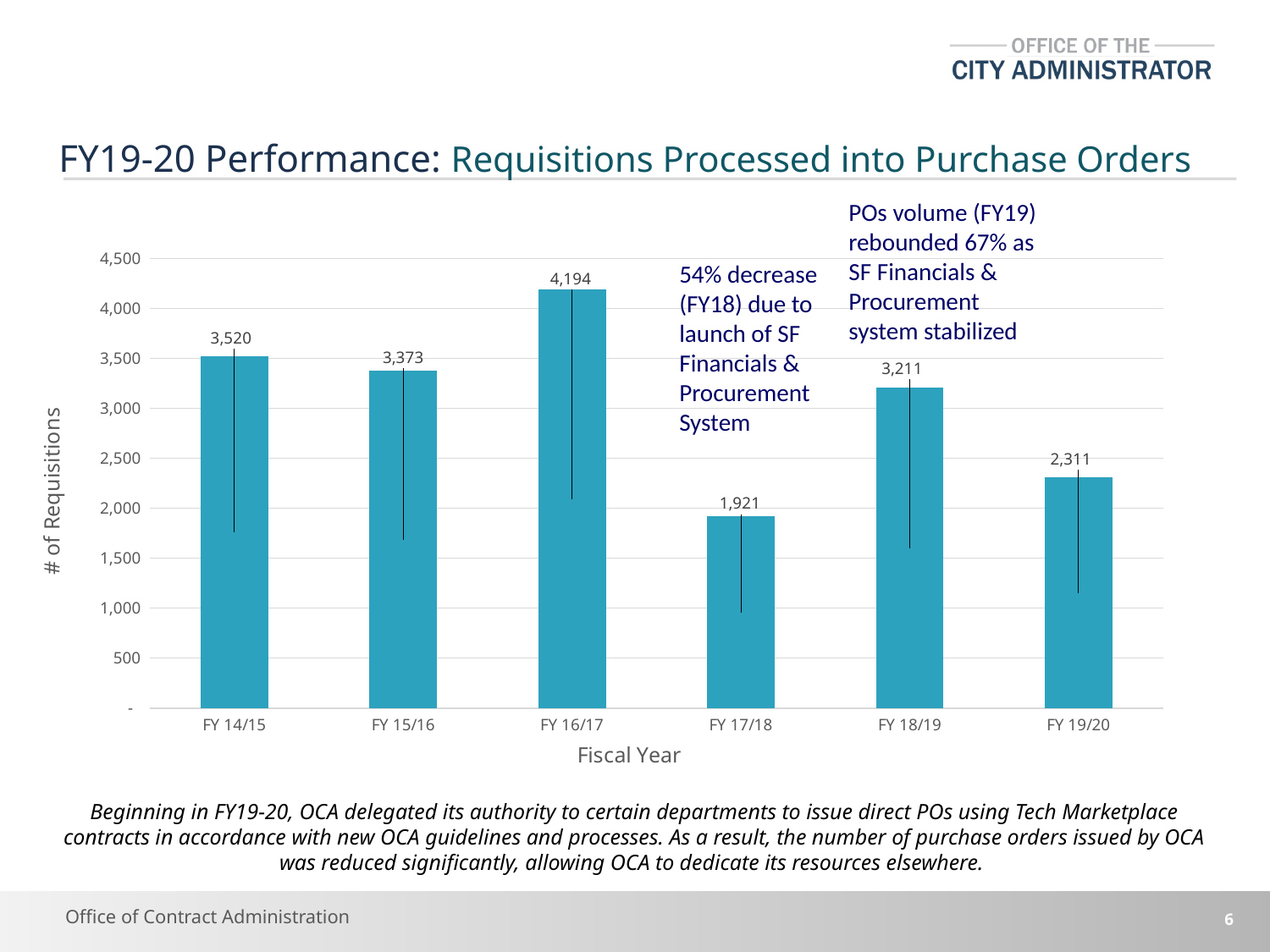
What kind of chart is shown on the slide? Bar chart Which fiscal year has the highest number of requisitions? FY 16/17 What is the number of requisitions for FY 16/17? 4,194 Which has more requisitions, FY 14/15 or FY 15/16? FY 14/15 What is the difference in requisitions between FY 18/19 and FY 19/20? 900 What is the number of requisitions for FY 14/15? 3,520 What is the label of the y axis? # of Requisitions Which fiscal year has the lowest number of requisitions? FY 17/18 What is the difference in requisitions between FY 16/17 and FY 17/18? 2,273 Is the value for FY 18/19 greater or less than 3,000? greater What is the number of requisitions for FY 19/20? 2,311 How many fiscal years are shown on the x axis? 6